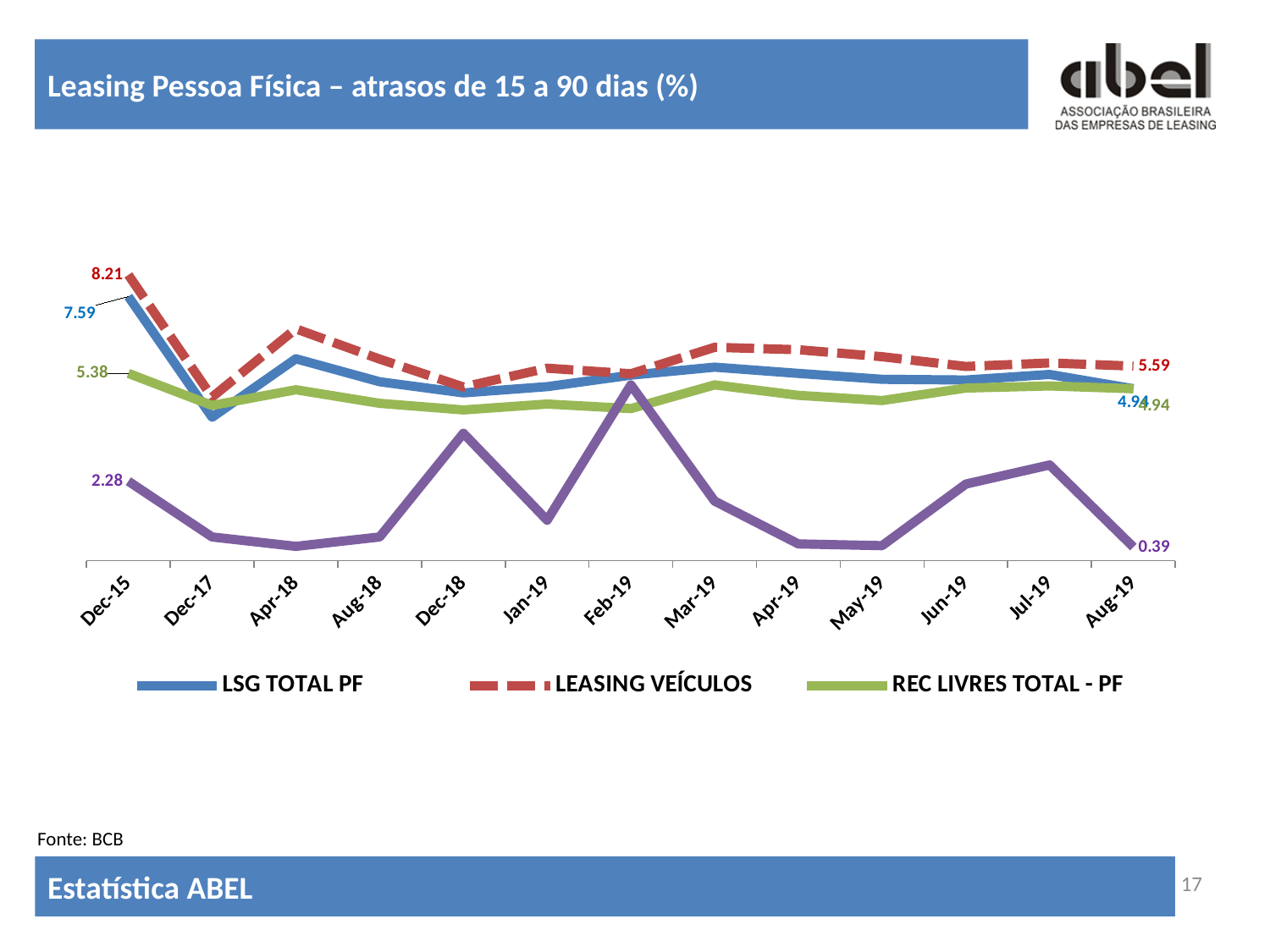
At Dec-15, which is higher: LEASING VEÍCULOS or REC LIVRES TOTAL - PF? LEASING VEÍCULOS By how much did LEASING VEÍCULOS fall from Dec-15 to Aug-19? 2.62 Does the LEASING VEÍCULOS series rise or fall from Dec-15 to Aug-19? Fall What is the value of REC LIVRES TOTAL - PF at Dec-15? 5.38 What is the value of LSG TOTAL PF at Aug-19? 4.94 What is the difference between LEASING VEÍCULOS and LSG TOTAL PF at Dec-15? 0.62 How many series does the legend list? 3 What kind of chart is shown on the slide? Line chart What is the value of LEASING VEÍCULOS at Aug-19? 5.59 What is the value of LSG TOTAL PF at Dec-15? 7.59 Which series has the highest value at Dec-15? LEASING VEÍCULOS What is the value of LEASING VEÍCULOS at Dec-15? 8.21